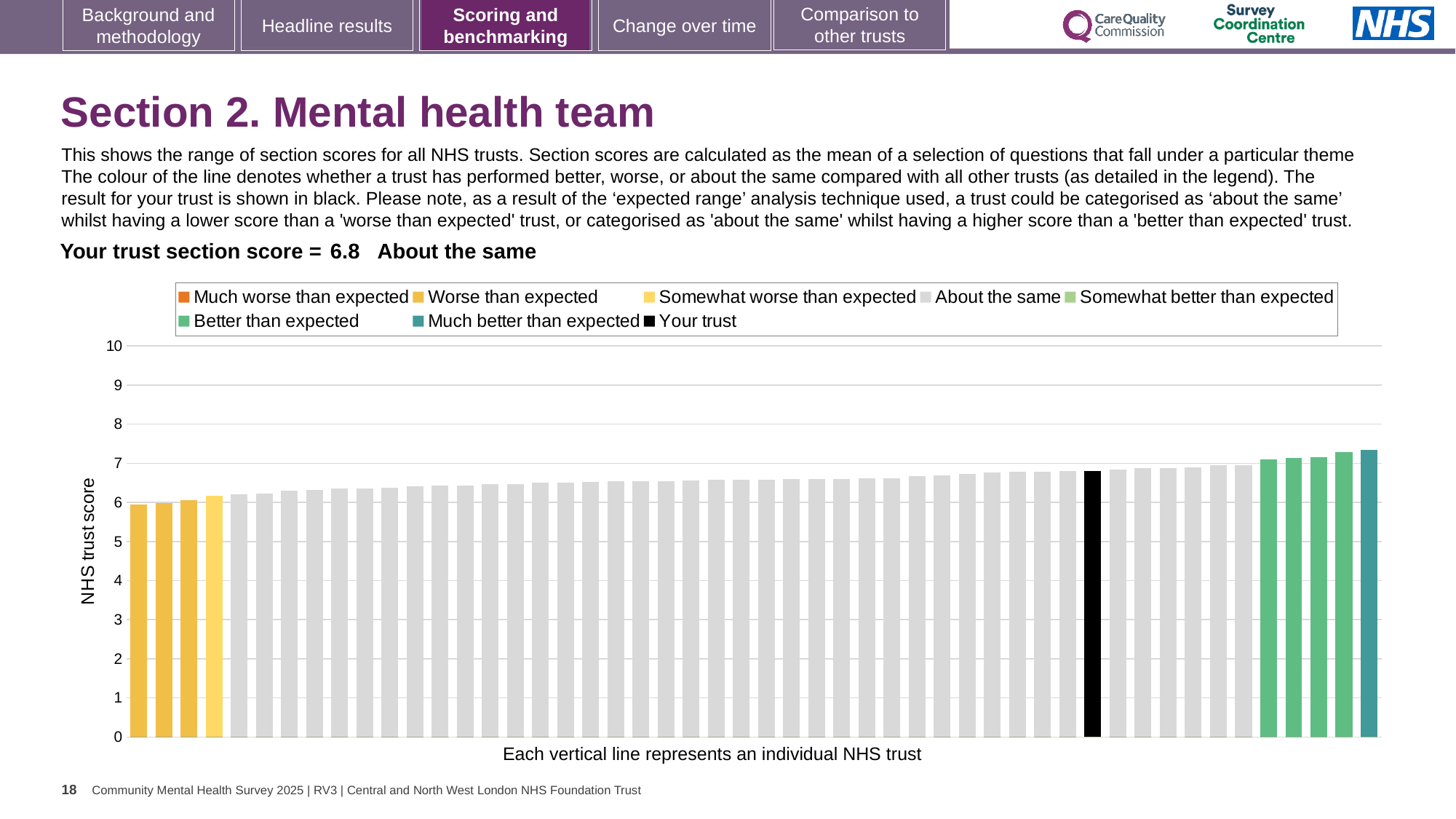
How many entries does the chart legend list? 8 Is the value of the shortest bar greater or less than 5? greater What is the section score for your trust shown on the slide? 6.8 What is the highest tick value shown on the vertical axis? 10 What kind of chart is shown on the slide? bar chart What colour is the bar representing your trust? black Which category is your trust's section score placed in? About the same Do the bar values rise or fall from left to right along the x axis? rise Is the value of the tallest bar greater or less than 7? greater Is the value of the black 'Your trust' bar greater or less than 7? less What is the label of the vertical axis? NHS trust score How many bars are coloured as 'Much better than expected'? 1